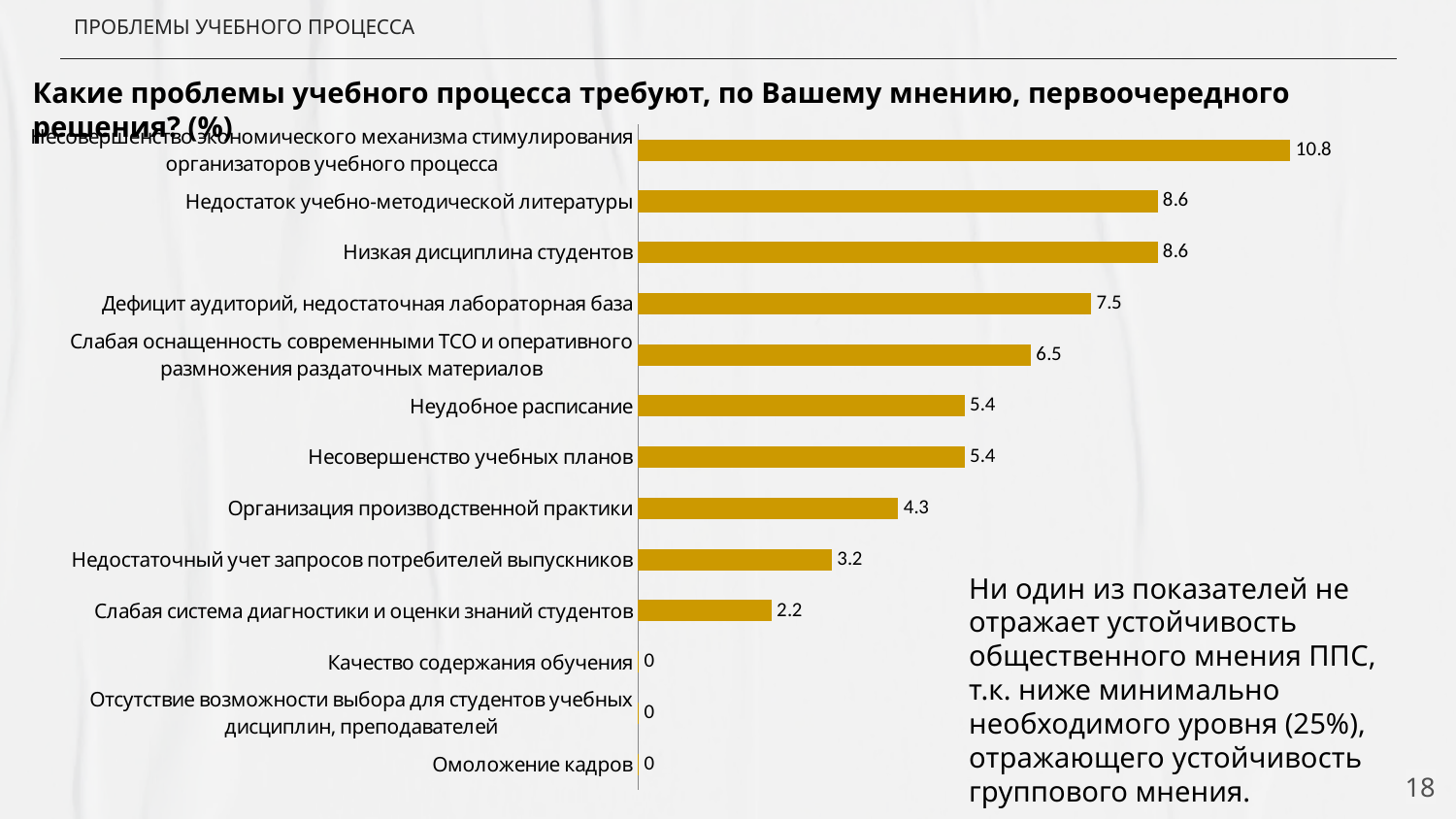
How many categories have a value of 0? 3 What is the difference between the values for «Недостаточный учет запросов потребителей выпускников» and «Слабая система диагностики и оценки знаний студентов»? 1.0 What is the difference between the values for «Несовершенство экономического механизма стимулирования организаторов учебного процесса» and «Низкая дисциплина студентов»? 2.2 What is the value for «Несовершенство экономического механизма стимулирования организаторов учебного процесса»? 10.8 What is the value for «Организация производственной практики»? 4.3 What is the value for «Дефицит аудиторий, недостаточная лабораторная база»? 7.5 What is the value for «Слабая система диагностики и оценки знаний студентов»? 2.2 How many categories are shown in the chart? 13 Which is larger: the value for «Дефицит аудиторий, недостаточная лабораторная база» or for «Неудобное расписание»? Дефицит аудиторий, недостаточная лабораторная база Which category has the highest value? Несовершенство экономического механизма стимулирования организаторов учебного процесса What kind of chart is shown on the slide? Bar chart What is the value for «Омоложение кадров»? 0